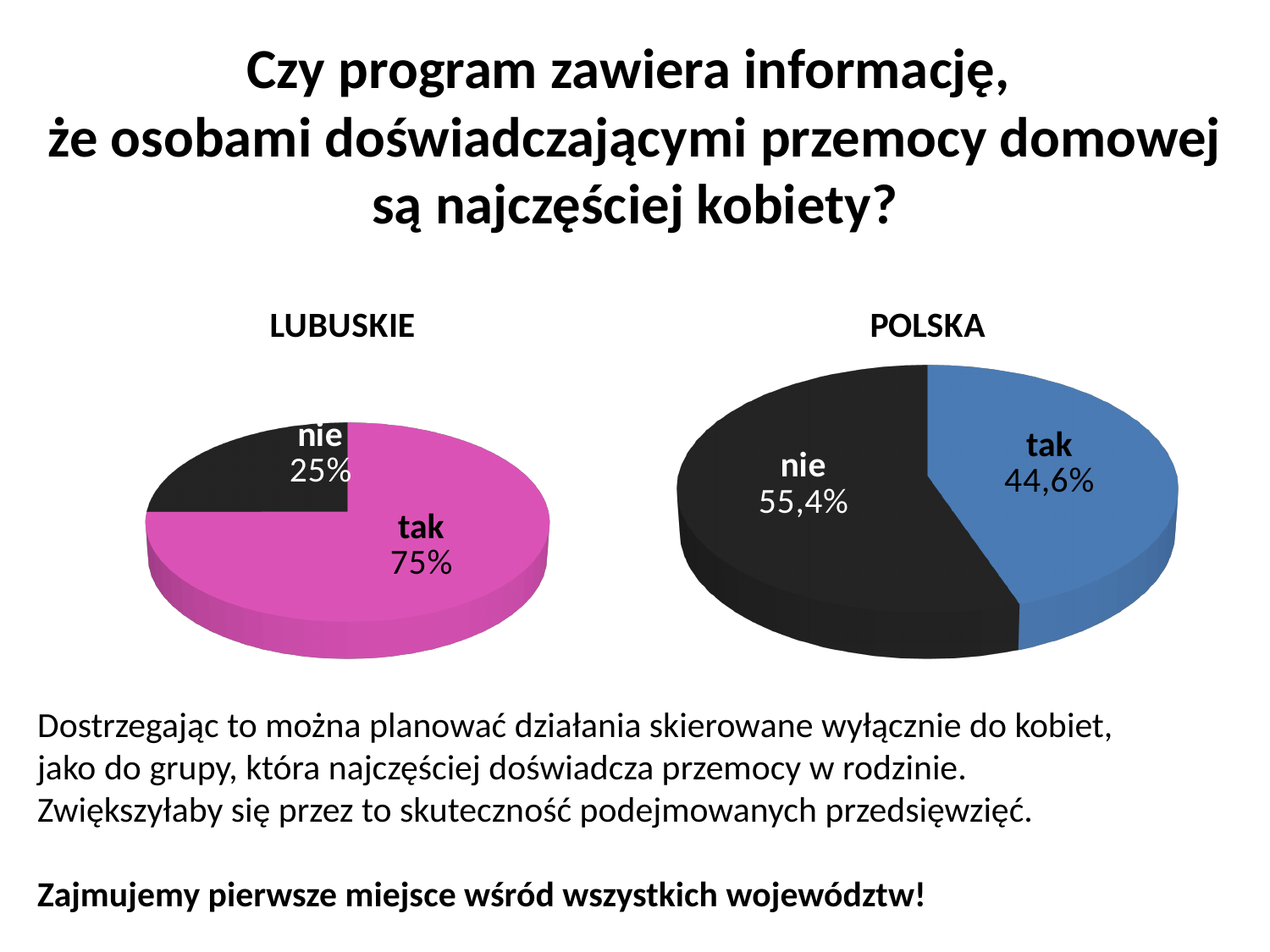
In the POLSKA chart, what is the difference between "nie" and "tak"? 10,8% How many slices does the POLSKA chart have? 2 In the LUBUSKIE chart, what is the value for "tak"? 75% In the LUBUSKIE chart, what is the difference between "tak" and "nie"? 50% Which is larger: "tak" in the LUBUSKIE chart or "tak" in the POLSKA chart? tak in the LUBUSKIE chart In the LUBUSKIE chart, which slice is the largest? tak In the POLSKA chart, which slice is the smallest? tak In the POLSKA chart, what is the value for "nie"? 55,4% In the POLSKA chart, what is the value for "tak"? 44,6% In the LUBUSKIE chart, what colour is the "tak" slice? pink What kind of chart is the LUBUSKIE chart? pie chart In the LUBUSKIE chart, what is the value for "nie"? 25%